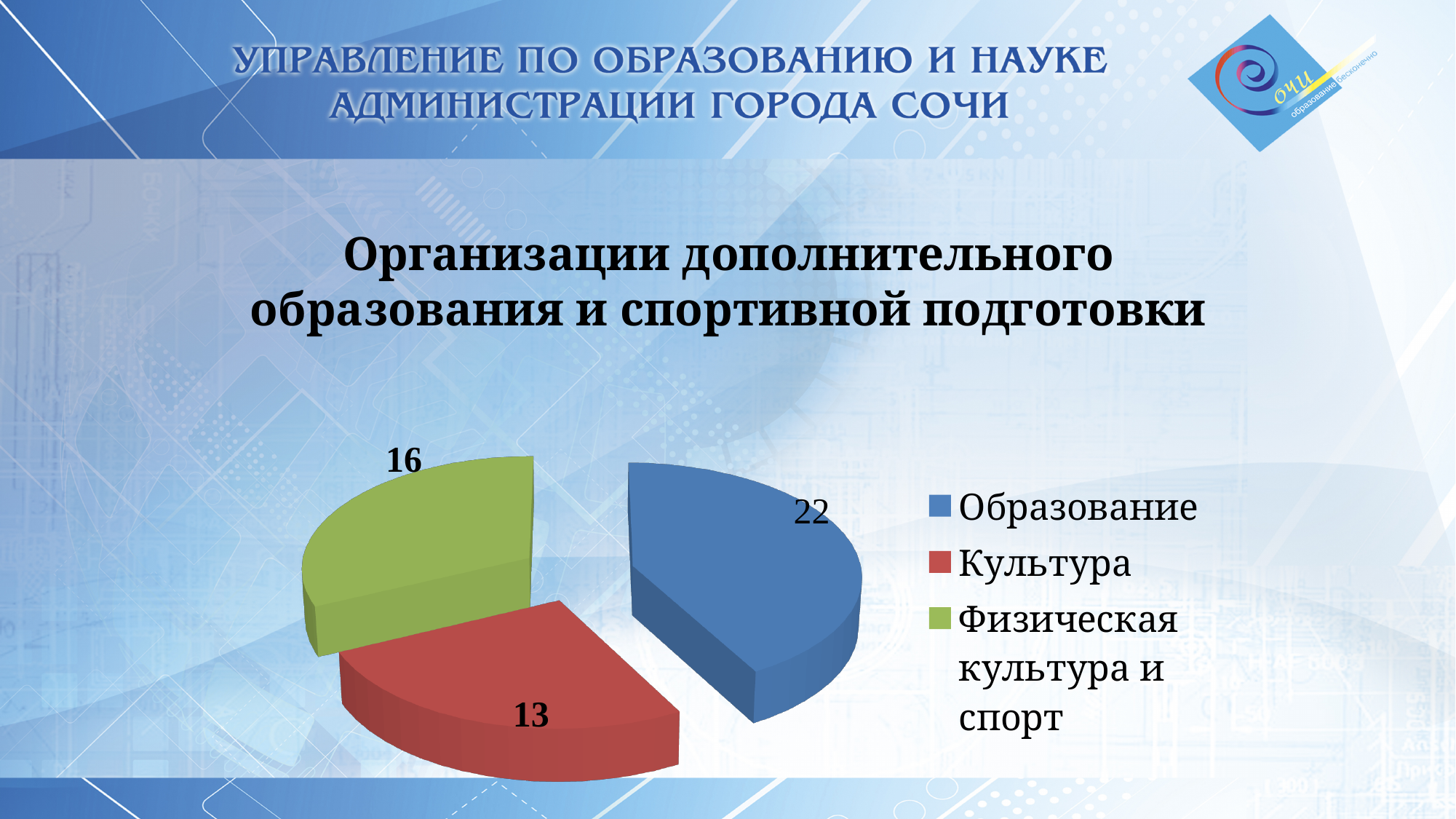
What is the value for Образование in the pie chart? 22 What is the difference between the values for Образование and Культура? 9 What type of chart is shown on the slide? pie chart How many categories does the pie chart have? 3 What is the value for Культура in the pie chart? 13 What is the total of all slices in the pie chart? 51 Which is larger, the value for Физическая культура и спорт or the value for Культура? Физическая культура и спорт What colour is the slice for Культура? red What is the difference between the values for Физическая культура и спорт and Культура? 3 Which category has the largest slice in the pie chart? Образование Which category has the smallest slice in the pie chart? Культура What is the value for Физическая культура и спорт in the pie chart? 16